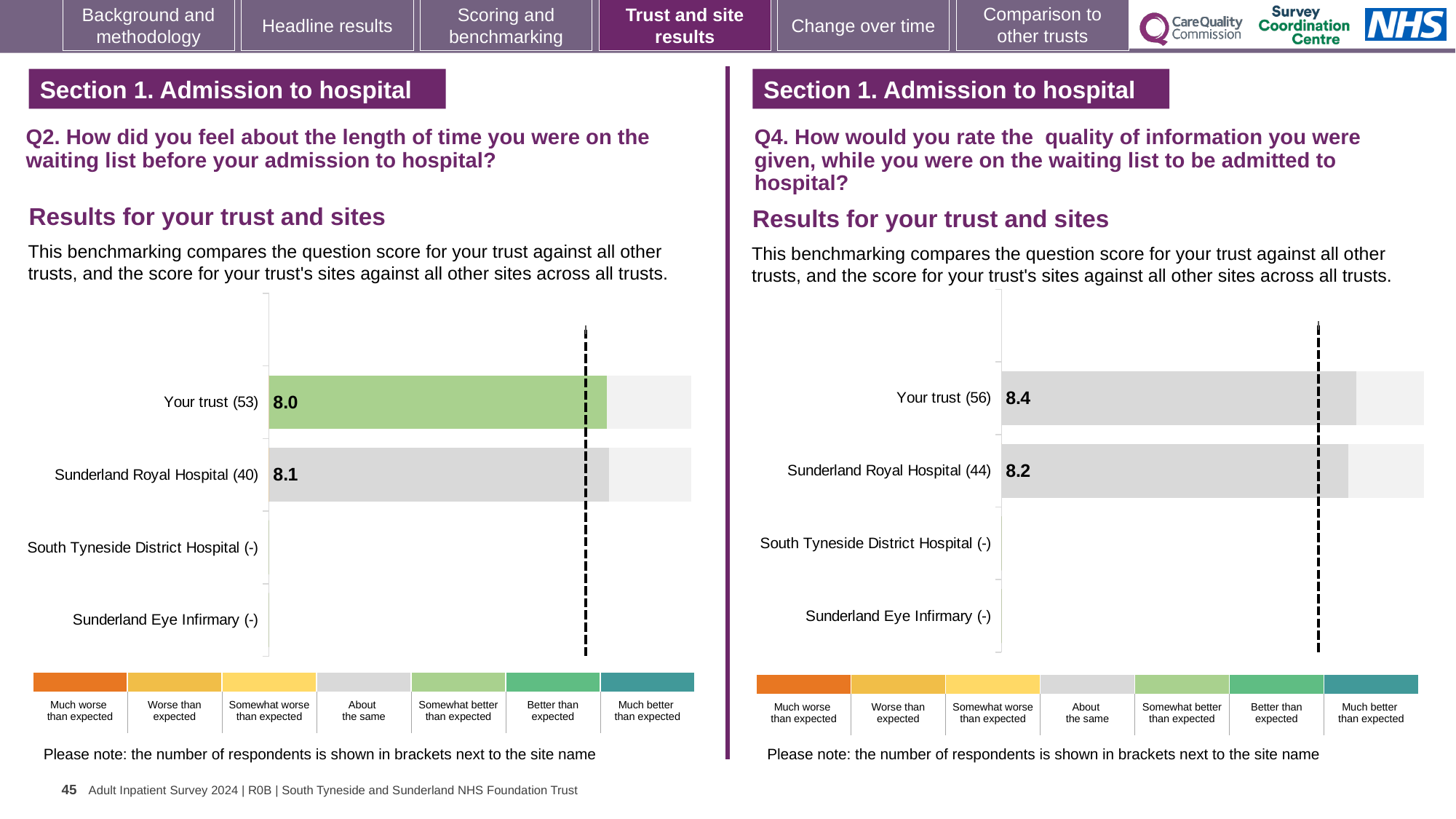
In the Q4 chart on the right, what is the score for Your trust? 8.4 In the Q4 chart on the right, which has the higher score: Your trust or Sunderland Royal Hospital? Your trust In the Q2 chart on the left, which has the higher score: Your trust or Sunderland Royal Hospital? Sunderland Royal Hospital In the Q2 chart on the left, which benchmark category does the green colour of the Your trust bar correspond to in the legend? Somewhat better than expected How many categories are listed on the y axis of the Q2 chart on the left? 4 In the Q2 chart on the left, what is the score for Your trust? 8.0 In the Q2 chart on the left, what is the score for Sunderland Royal Hospital? 8.1 In the Q4 chart on the right, what is the difference between the scores for Your trust and Sunderland Royal Hospital? 0.2 In the Q4 chart on the right, what is the score for Sunderland Royal Hospital? 8.2 In the Q4 chart on the right, how many respondents are shown in brackets for Sunderland Royal Hospital? 44 In the Q2 chart on the left, how many respondents are shown in brackets for Your trust? 53 What kind of chart is used for the Q4 results on the right? Bar chart